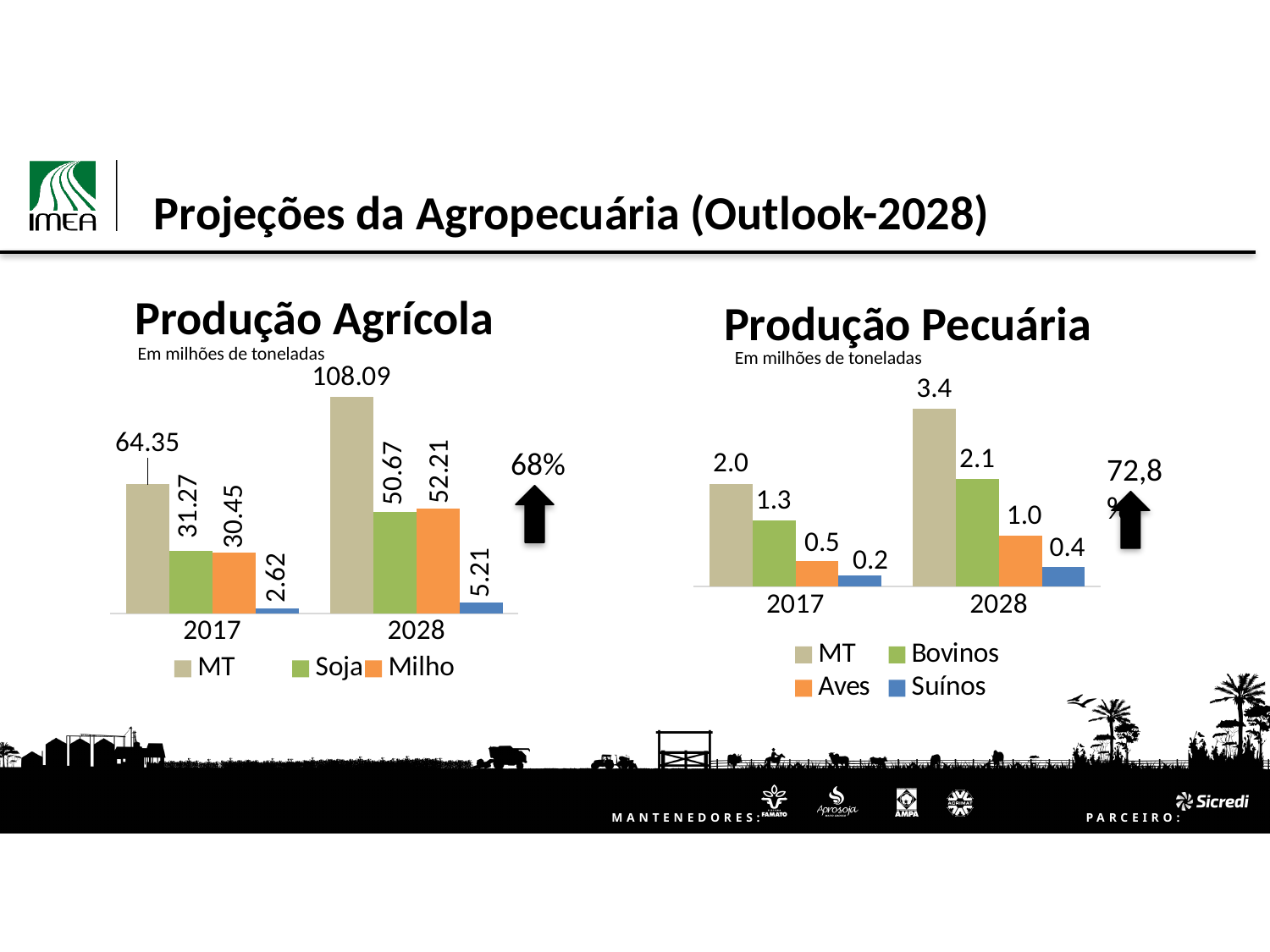
In the Produção Agrícola chart, what is the value for Milho in 2028? 52.21 In the Produção Agrícola chart, does the MT value rise or fall from 2017 to 2028? rise In the Produção Agrícola chart, what is the value for Soja in 2017? 31.27 What kind of chart is the Produção Pecuária chart? bar chart How many series does the legend of the Produção Pecuária chart list? 4 In the Produção Agrícola chart, what is the value for MT in 2028? 108.09 In the Produção Pecuária chart, what is the difference between the MT values for 2028 and 2017? 1.4 In the Produção Agrícola chart, by how much does the MT value increase from 2017 to 2028? 43.74 In the Produção Pecuária chart, what is the value for Suínos in 2017? 0.2 In the Produção Pecuária chart, which series has the lowest value in 2028? Suínos In the Produção Agrícola chart, which is larger in 2028, Soja or Milho? Milho In the Produção Pecuária chart, what is the value for Bovinos in 2028? 2.1